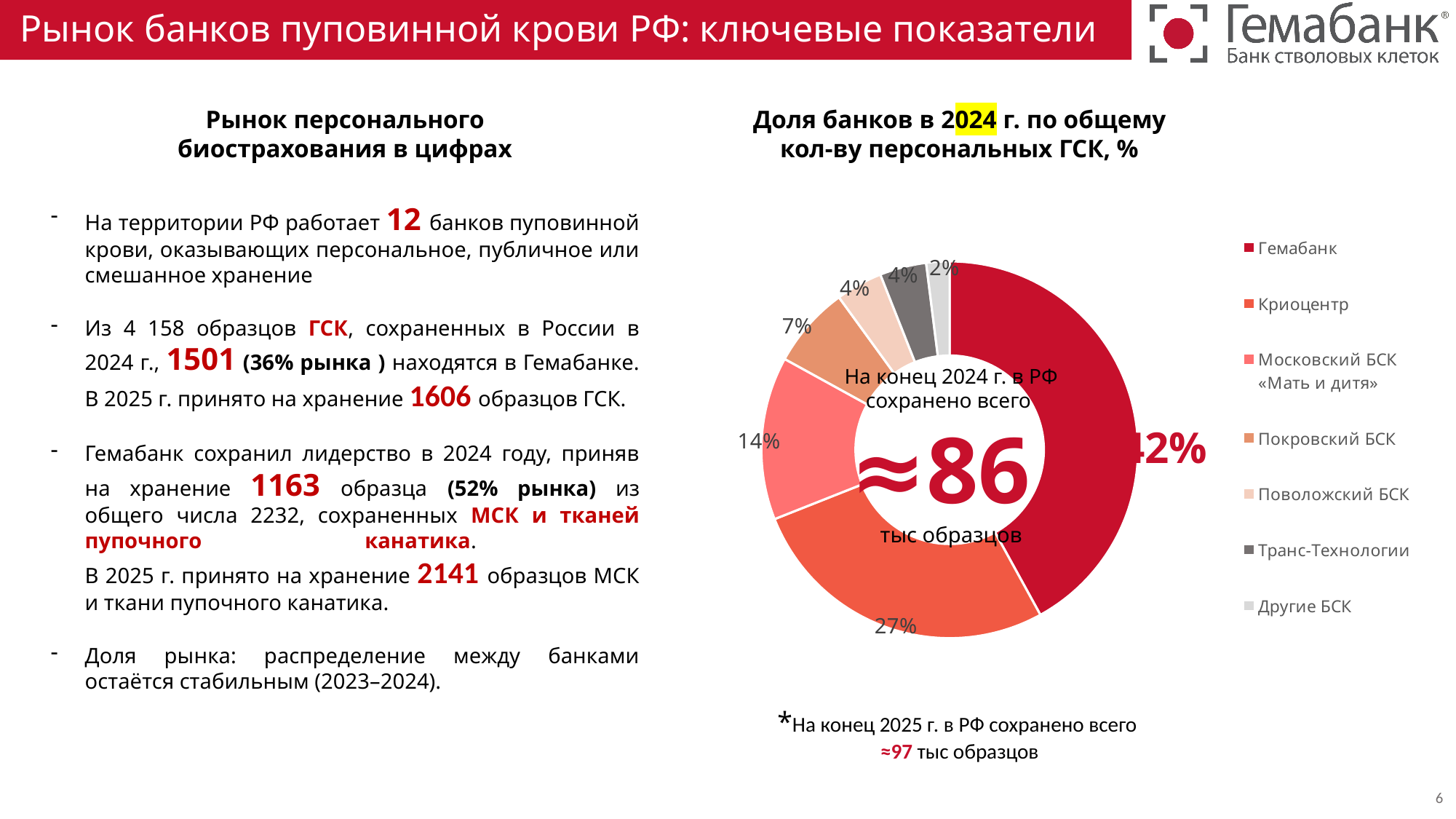
What is the share of Покровский БСК in the doughnut chart? 7% What is the share of Другие БСК in the doughnut chart? 2% What is the share of Криоцентр in the doughnut chart? 27% Which category has the smallest share in the doughnut chart? Другие БСК What is the title of the doughnut chart? Доля банков в 2024 г. по общему кол-ву персональных ГСК, % How many banks (categories) does the legend of the doughnut chart list? 7 Which has a larger share: Покровский БСК or Московский БСК «Мать и дитя»? Московский БСК «Мать и дитя» What kind of chart is shown on the slide? Doughnut (pie) chart What is the difference in percentage points between the shares of Криоцентр and Московский БСК «Мать и дитя»? 13 percentage points Which bank has the largest share in the doughnut chart? Гемабанк What total number of samples is shown in the centre of the doughnut chart? ≈86 тыс образцов What is the share of Московский БСК «Мать и дитя» in the doughnut chart? 14%